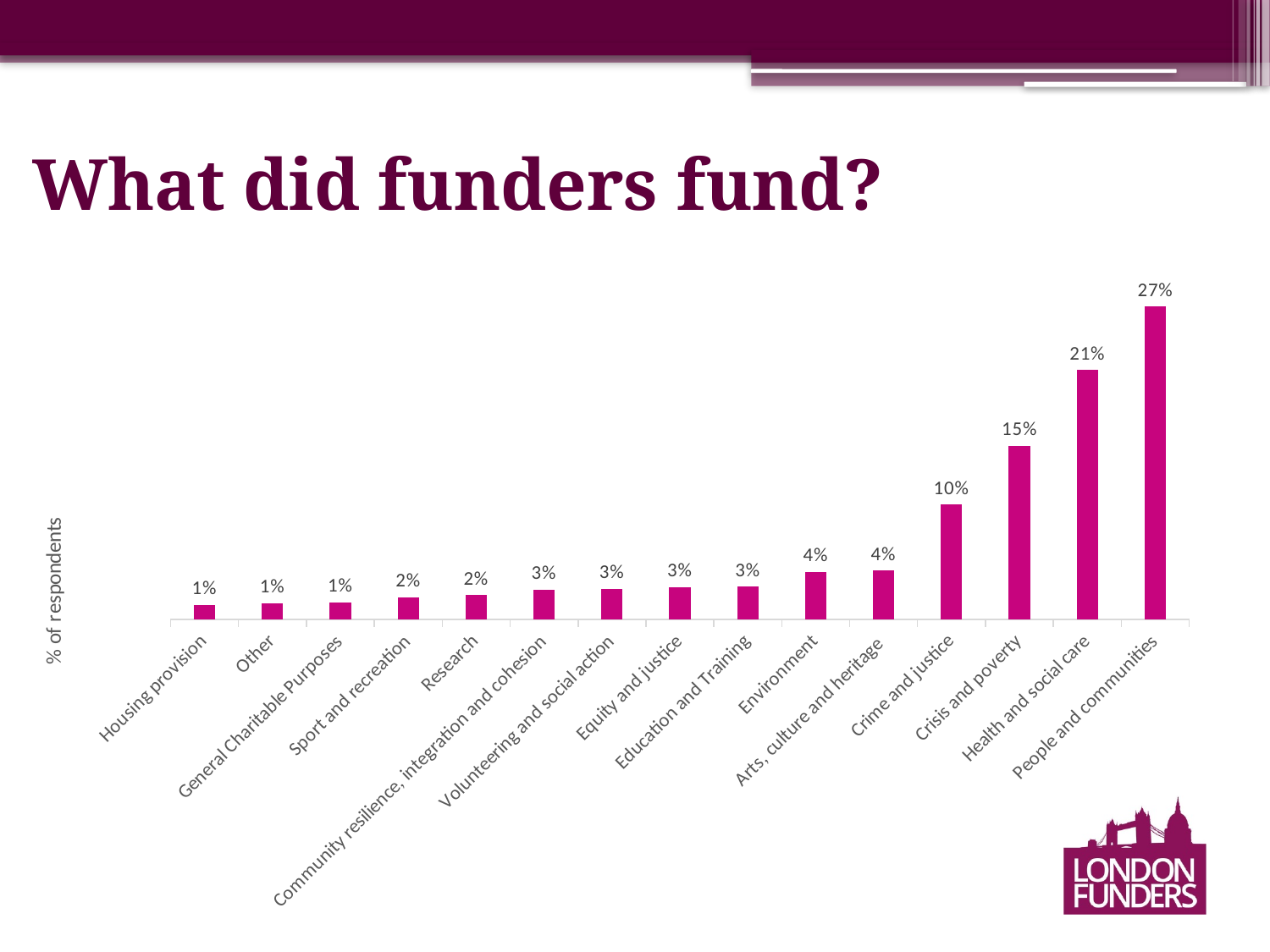
What is the difference between Crisis and poverty and Crime and justice? 5% Which is larger, Crisis and poverty or Crime and justice? Crisis and poverty What is the lowest value shown on the chart? 1% How many categories are shown on the chart? 15 What is the value for Crime and justice? 10% What kind of chart is shown on the slide? Bar chart What is the difference between People and communities and Health and social care? 6% What percentage of respondents funded People and communities? 27% Do the values rise or fall from left to right along the x axis? Rise What is the value for Environment? 4% Which category has the highest value? People and communities What is the value for Health and social care? 21%